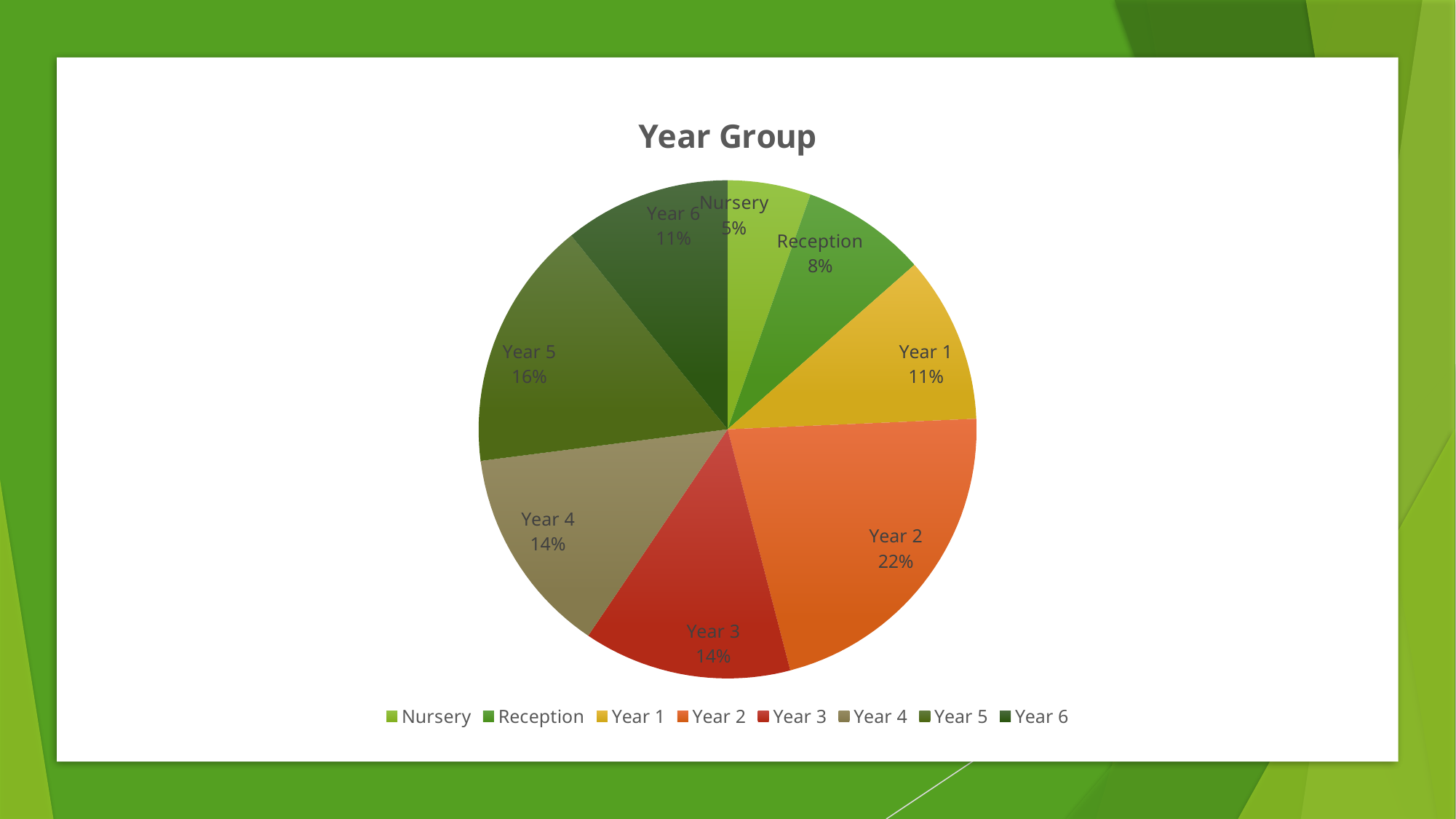
What percentage is shown for Reception? 8% Which is larger, the share for Year 4 or the share for Reception? Year 4 What is the difference in percentage points between Year 2 and Year 5? 6 What type of chart is shown on the slide? Pie chart How many entries does the legend list? 8 Which year group has the smallest share of the pie? Nursery What share of the pie does Year 2 represent? 22% What is the title of the chart? Year Group What percentage is shown for Year 5? 16% What percentage is shown for Nursery? 5% Which year group has the largest share of the pie? Year 2 How many categories does the pie chart have? 8